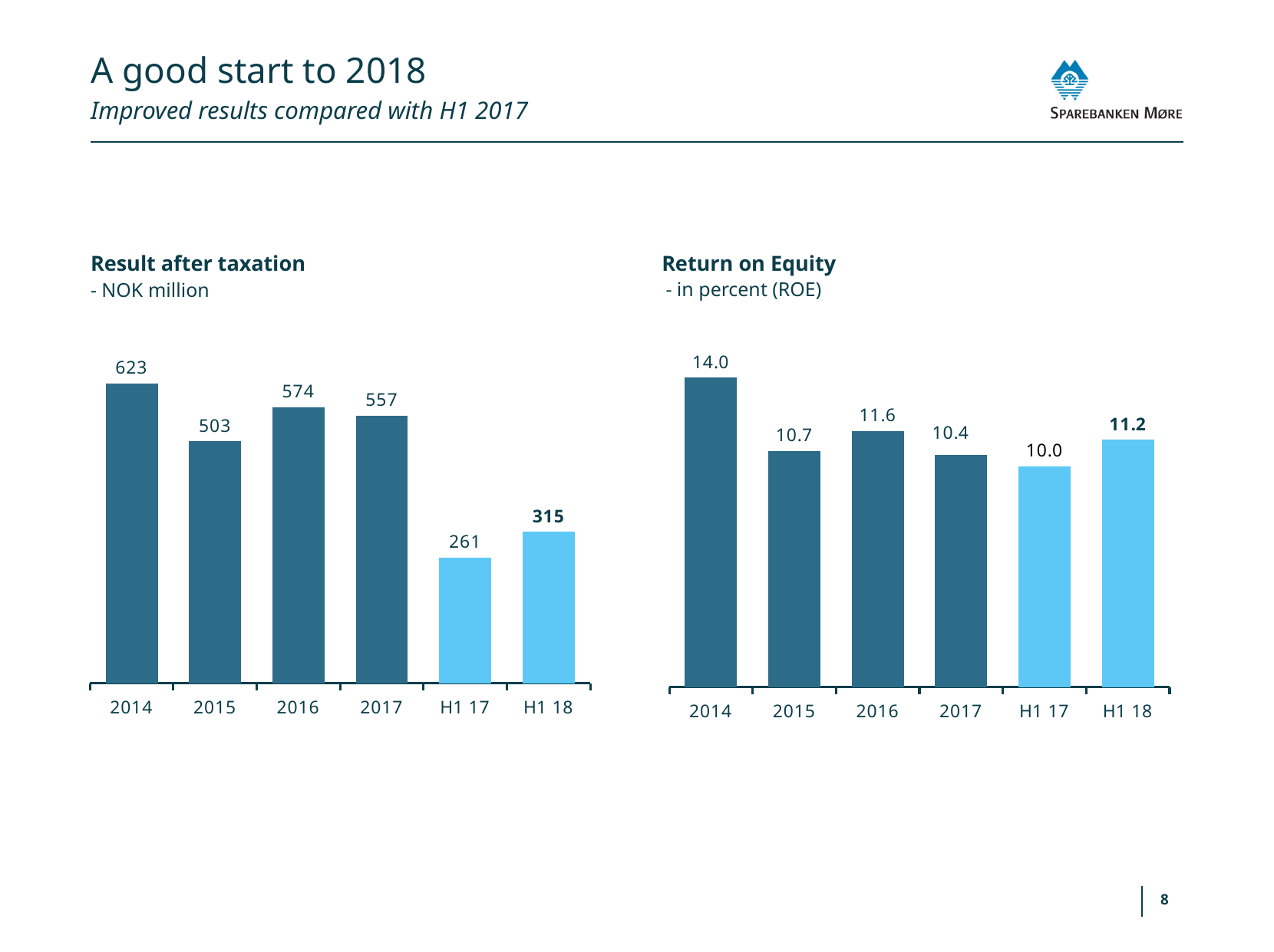
In the 'Return on Equity' chart, which is larger, the value for 2016 or the value for 2017? 2016 In the 'Return on Equity' chart, what is the value for H1 18? 11.2 In the 'Return on Equity' chart, what is the difference between the values for 2014 and 2017? 3.6 In the 'Result after taxation' chart, what is the value for H1 18? 315 In the 'Return on Equity' chart, which category has the highest value? 2014 In the 'Result after taxation' chart, what is the value for 2016? 574 In the 'Result after taxation' chart, what is the difference between the values for H1 18 and H1 17? 54 In the 'Result after taxation' chart, which category has the highest value? 2014 In the 'Result after taxation' chart, how many bars are plotted? 6 In the 'Return on Equity' chart, what is the value for 2015? 10.7 In the 'Result after taxation' chart, which category has the lowest value? H1 17 What kind of chart is the 'Return on Equity' chart? Bar chart